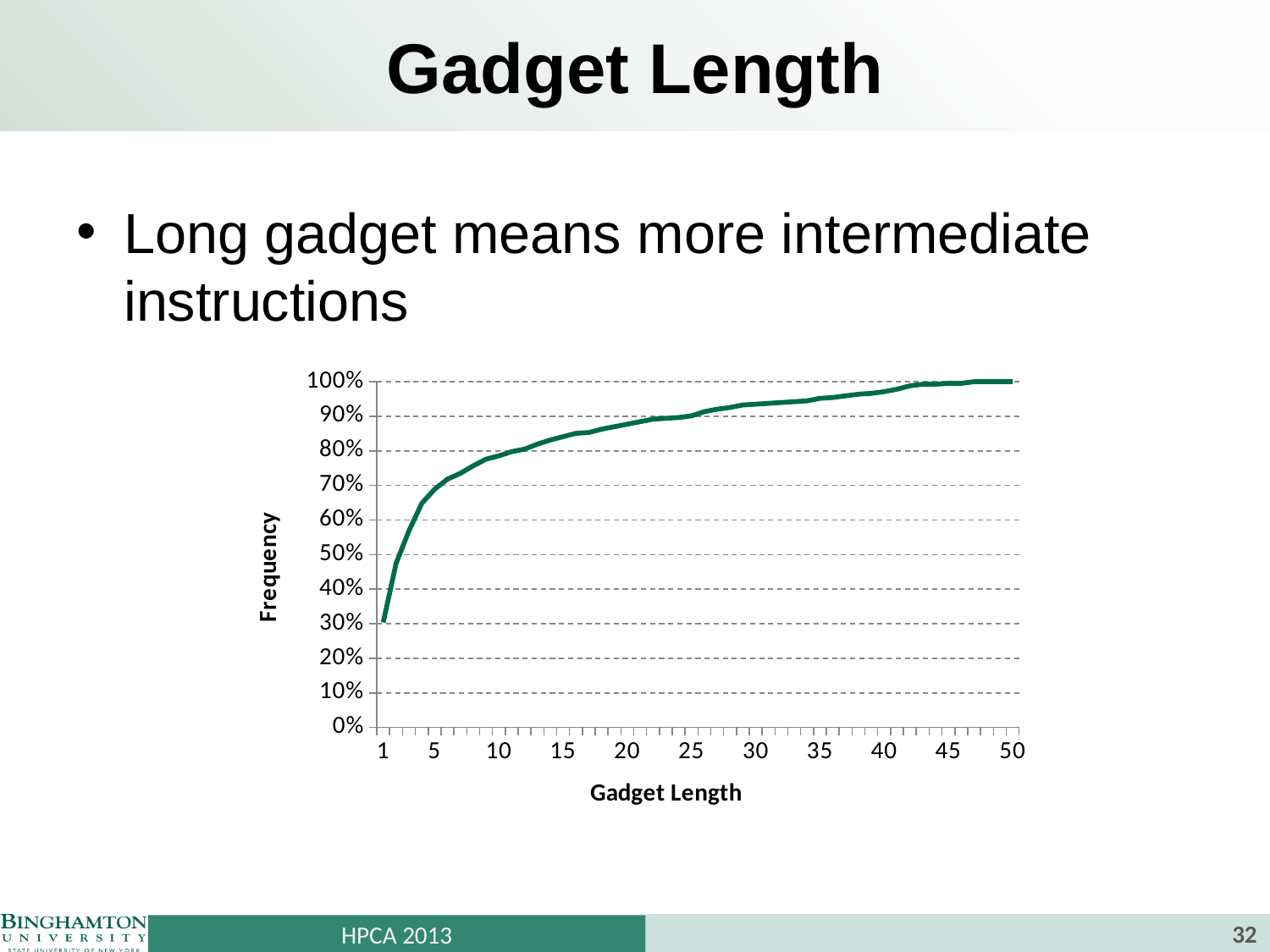
What kind of chart is shown on the slide? line chart Is the frequency at gadget length 5 greater or less than 60%? greater What is the title of the y axis of the chart? Frequency At which gadget length is the frequency lowest? 1 What frequency does the line reach at gadget length 50? 100% Is the frequency at gadget length 1 greater or less than 40%? less Is the frequency at gadget length 30 greater or less than 90%? greater What is the title of the x axis of the chart? Gadget Length Does the frequency rise or fall as gadget length increases along the x axis? rise Which has the higher frequency: gadget length 5 or gadget length 20? gadget length 20